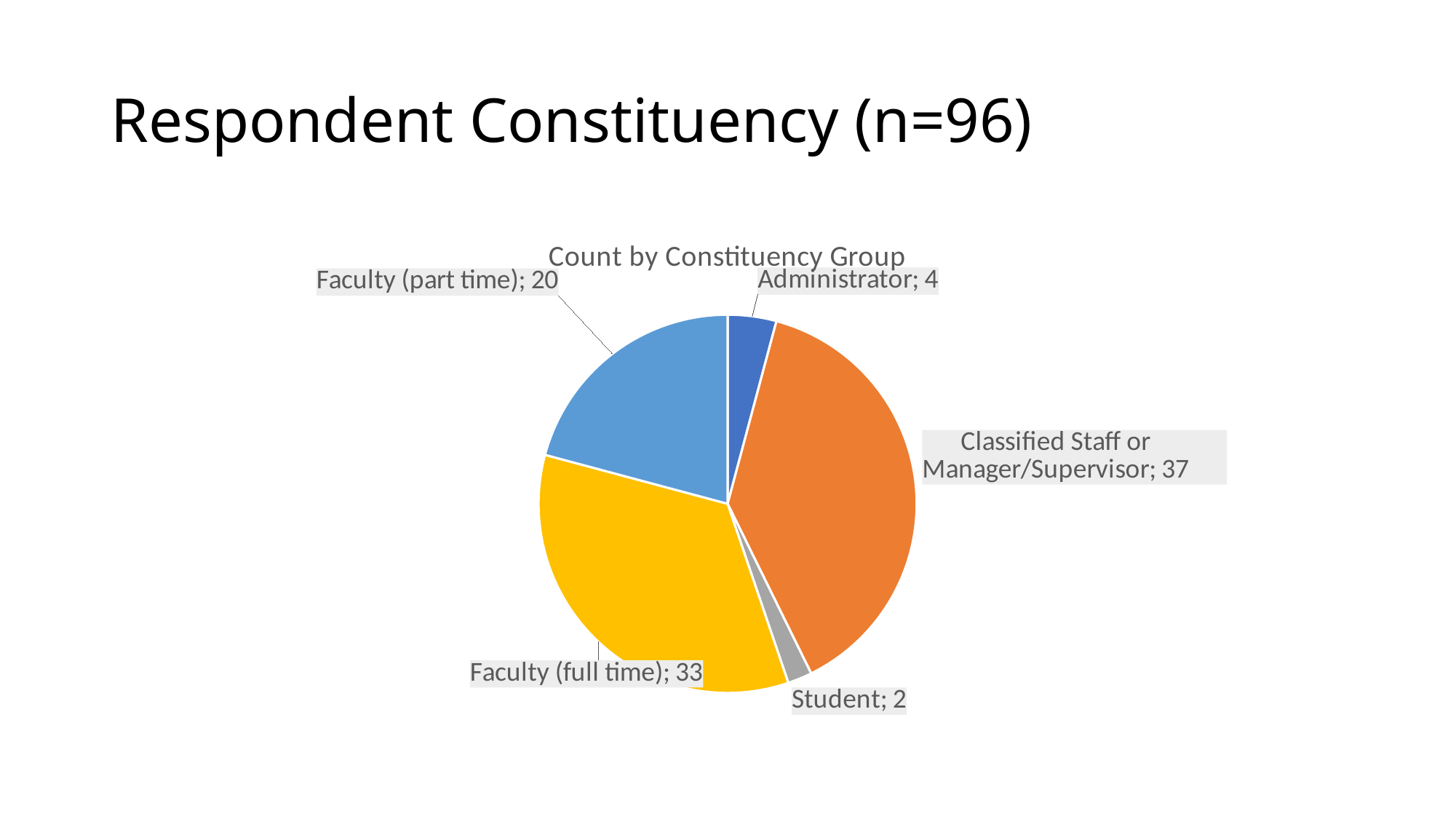
What is the count for Student? 2 Which constituency group has the highest count? Classified Staff or Manager/Supervisor Which constituency group has the lowest count? Student What kind of chart is shown on the slide? Pie chart What is the difference between the counts for Faculty (full time) and Faculty (part time)? 13 How many constituency groups are shown in the pie chart? 5 What is the count for Classified Staff or Manager/Supervisor? 37 What is the total count across all slices of the pie chart? 96 Which is larger, the count for Faculty (part time) or the count for Administrator? Faculty (part time) What is the count for Administrator? 4 What is the count for Faculty (full time)? 33 What is the title of the chart? Count by Constituency Group